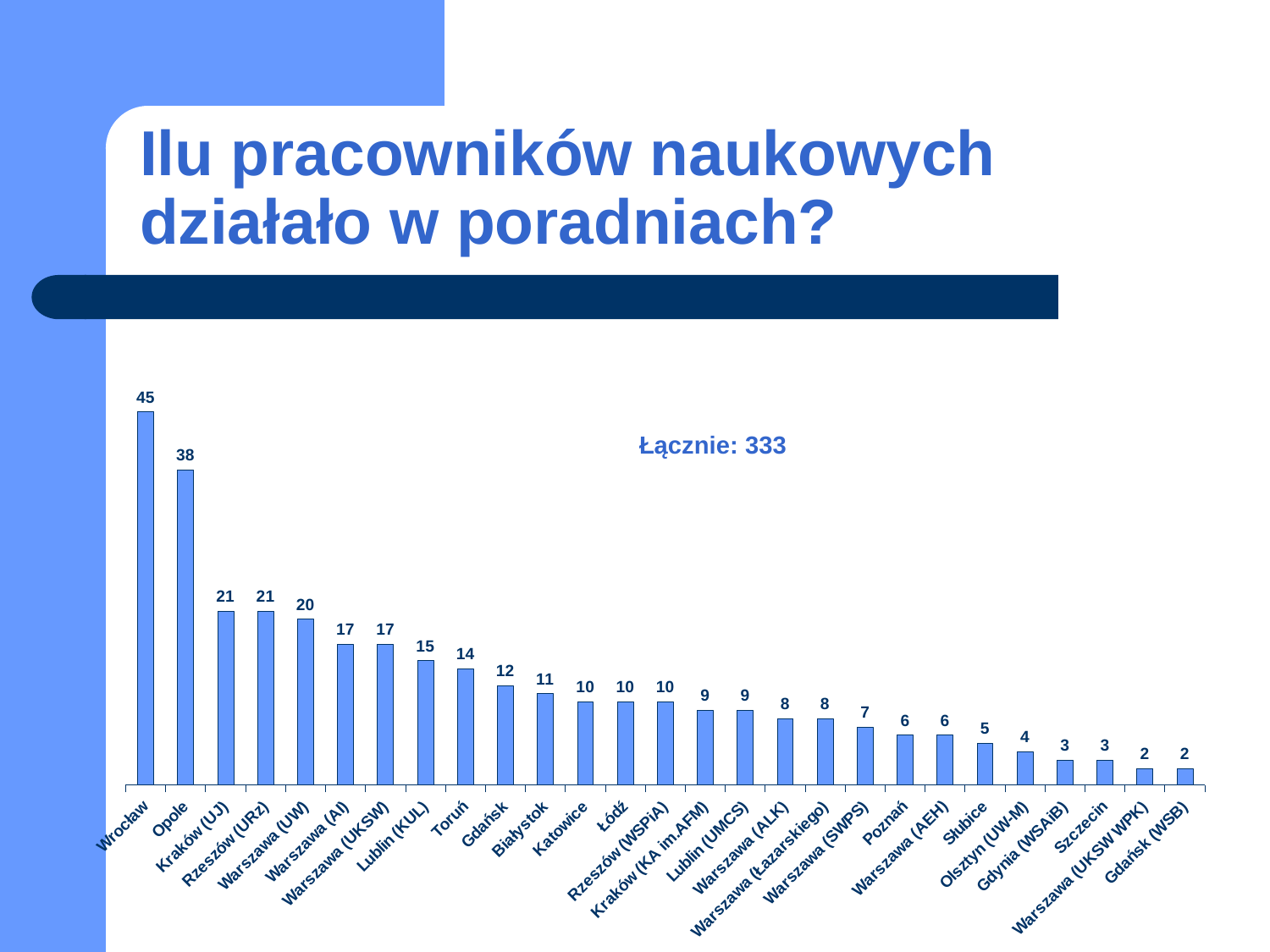
What is the lowest value shown on the chart? 2 What kind of chart is shown on the slide? Bar chart What is the value for Warszawa (SWPS)? 7 What total is stated in the text on the chart? Łącznie: 333 What is the value for Opole? 38 What is the difference between the values for Wrocław and Opole? 7 Which is larger, the value for Toruń or the value for Gdańsk? Toruń What is the value for Wrocław? 45 Which category has the highest value? Wrocław Do the values rise or fall from left to right along the x axis? Fall How many categories are shown on the chart? 27 What is the value for Lublin (KUL)? 15